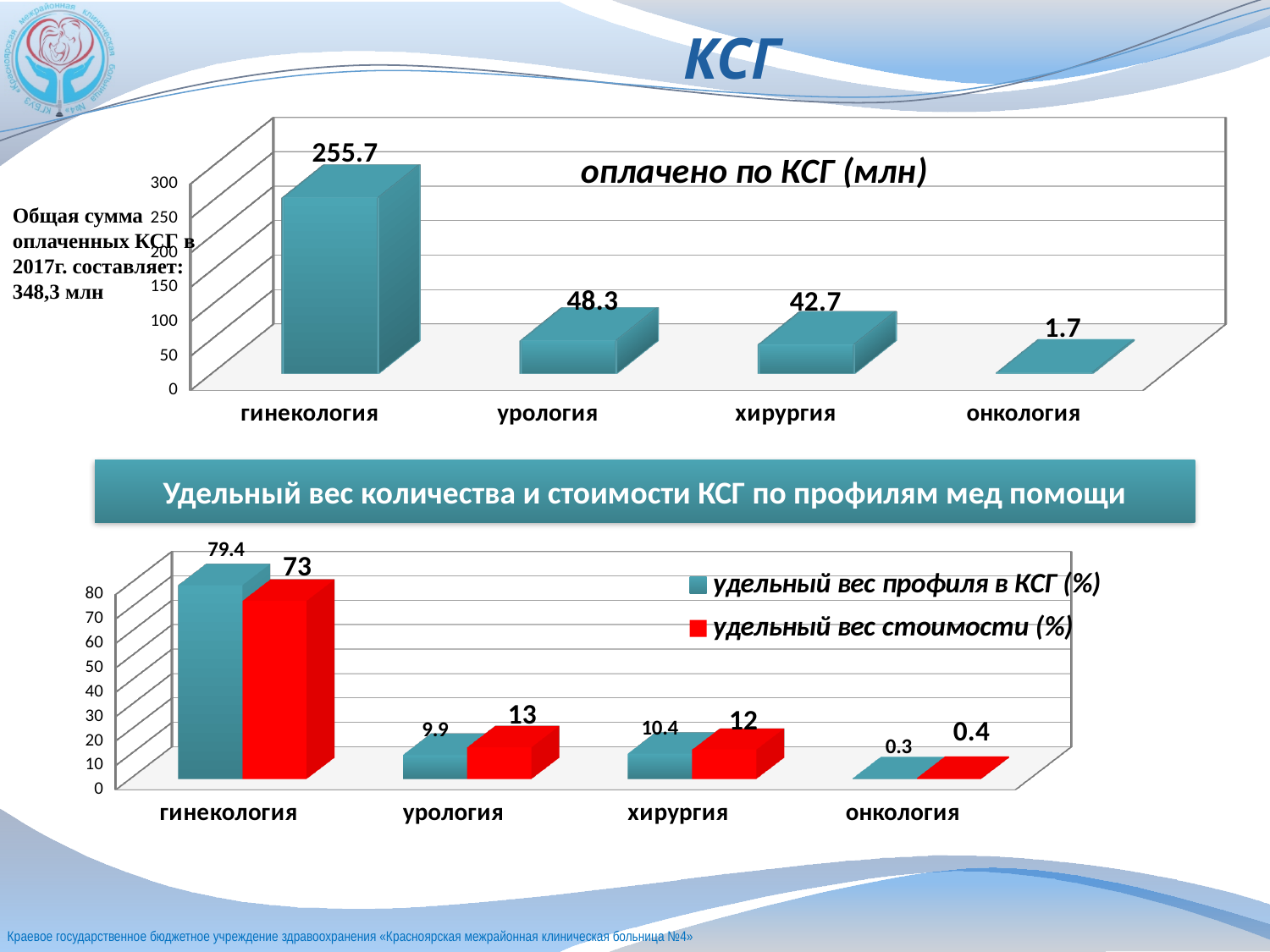
In the bottom chart 'Удельный вес количества и стоимости КСГ по профилям мед помощи', what is the difference between 'удельный вес профиля в КСГ (%)' and 'удельный вес стоимости (%)' for гинекология? 6.4 In the bottom chart 'Удельный вес количества и стоимости КСГ по профилям мед помощи', what is the value of 'удельный вес профиля в КСГ (%)' for хирургия? 10.4 In the bottom chart 'Удельный вес количества и стоимости КСГ по профилям мед помощи', what colour are the bars for 'удельный вес стоимости (%)'? red In the top chart 'оплачено по КСГ (млн)', what is the difference between урология and хирургия? 5.6 What type of chart is the top chart 'оплачено по КСГ (млн)'? bar chart In the bottom chart 'Удельный вес количества и стоимости КСГ по профилям мед помощи', which is larger for гинекология: 'удельный вес профиля в КСГ (%)' or 'удельный вес стоимости (%)'? удельный вес профиля в КСГ (%) In the top chart 'оплачено по КСГ (млн)', which category has the lowest value? онкология In the bottom chart 'Удельный вес количества и стоимости КСГ по профилям мед помощи', what is the value of 'удельный вес стоимости (%)' for урология? 13 In the top chart 'оплачено по КСГ (млн)', how many categories are shown? 4 In the bottom chart 'Удельный вес количества и стоимости КСГ по профилям мед помощи', how many series does the legend list? 2 In the top chart 'оплачено по КСГ (млн)', what is the value for гинекология? 255.7 In the top chart 'оплачено по КСГ (млн)', what is the value for хирургия? 42.7